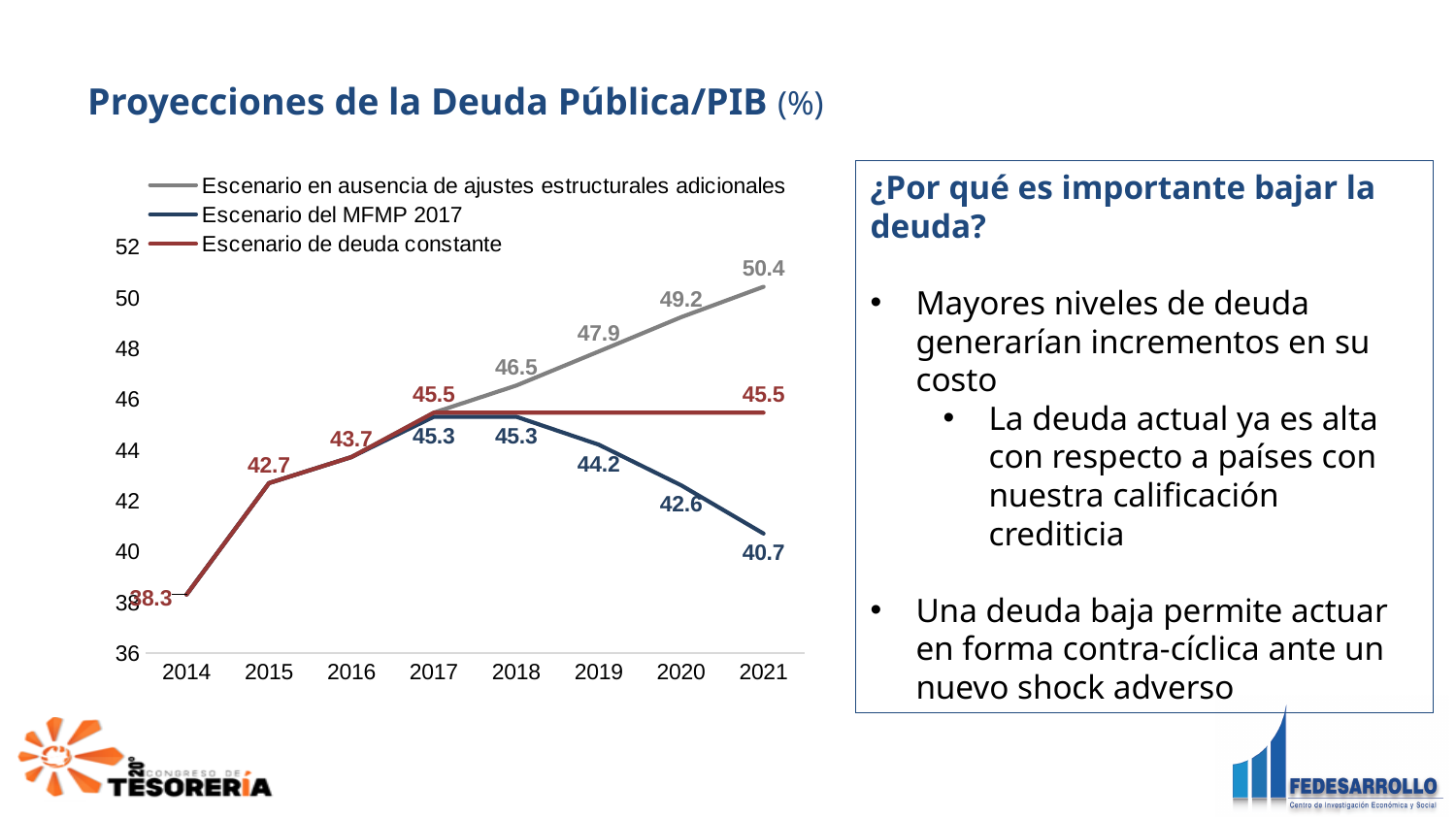
What is the title of the chart? Proyecciones de la Deuda Pública/PIB (%) What type of chart is shown on the slide? line chart What is the value for 2014? 38.3 Does the 'Escenario del MFMP 2017' series rise or fall from 2018 to 2021? fall What is the value for 2021 in the 'Escenario del MFMP 2017' series? 40.7 What is the difference between the 2021 values of the 'Escenario en ausencia de ajustes estructurales adicionales' series and the 'Escenario del MFMP 2017' series? 9.7 What is the value for 2021 in the 'Escenario en ausencia de ajustes estructurales adicionales' series? 50.4 Which series has the highest value in 2020? Escenario en ausencia de ajustes estructurales adicionales How many years are shown on the x axis? 8 What is the value for 2021 in the 'Escenario de deuda constante' series? 45.5 How many series does the legend list? 3 What is the value for 2019 in the 'Escenario del MFMP 2017' series? 44.2